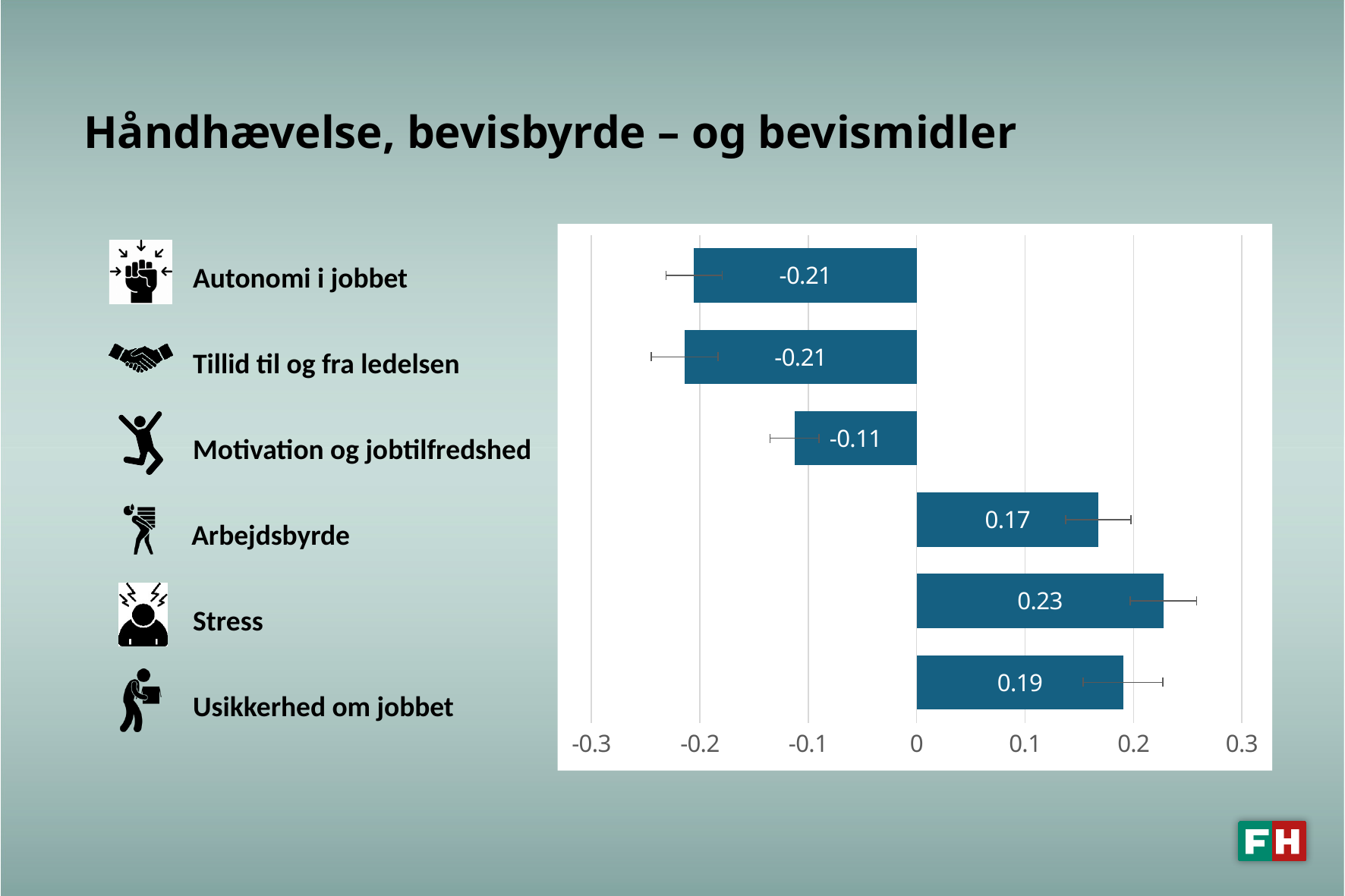
What is the value for Stress? 0.23 How many categories are shown in the chart? 6 What kind of chart is shown on the slide? Bar chart What is the value for Usikkerhed om jobbet? 0.19 What is the value for Autonomi i jobbet? -0.21 Which category has the highest value? Stress How many categories have negative values? 3 Which is larger, the value for Usikkerhed om jobbet or the value for Arbejdsbyrde? Usikkerhed om jobbet What is the difference between the values for Stress and Arbejdsbyrde? 0.06 Which category has the value closest to zero? Motivation og jobtilfredshed What is the value for Arbejdsbyrde? 0.17 What is the value for Motivation og jobtilfredshed? -0.11